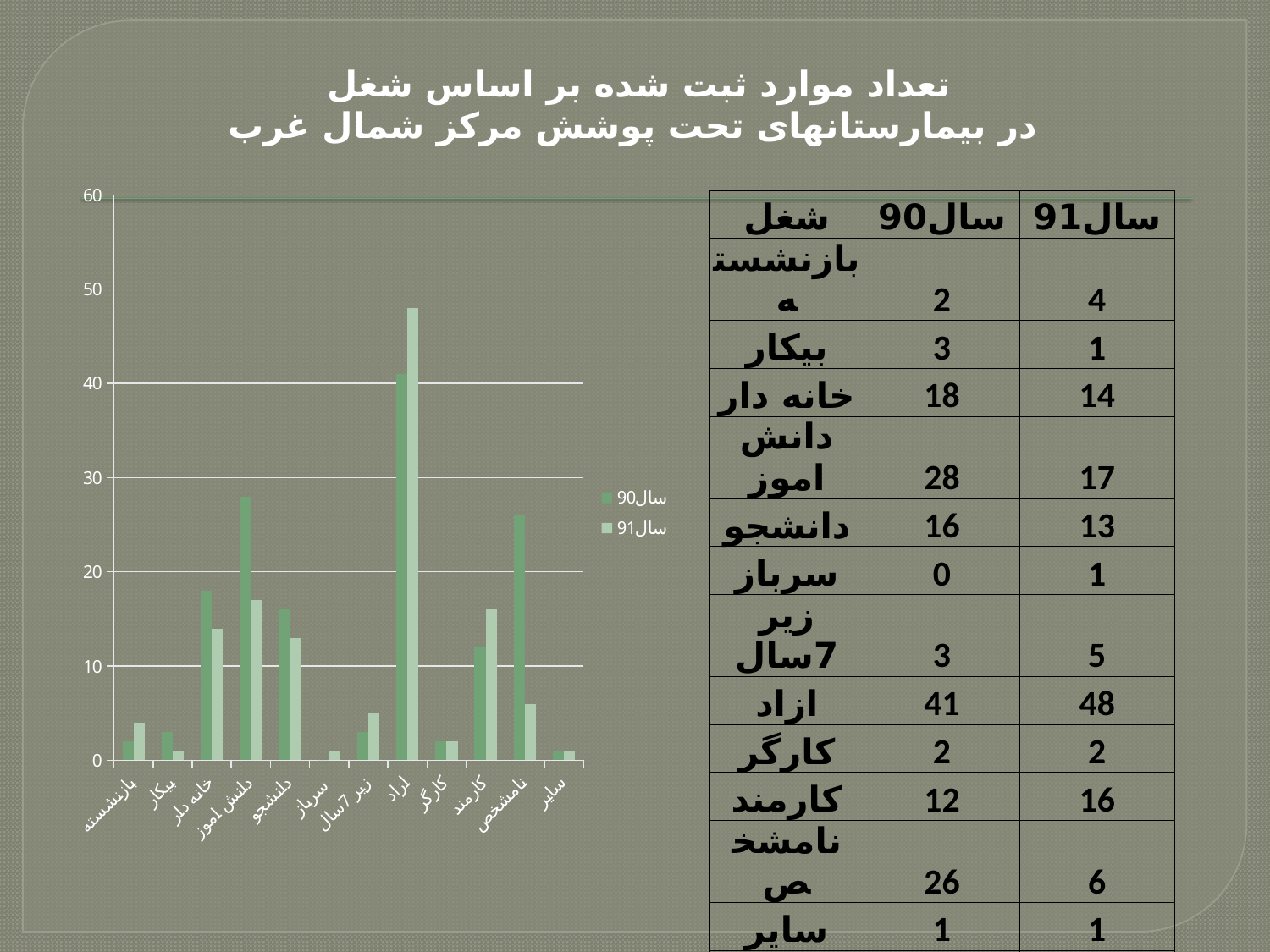
Which occupation category has the lowest value for سال90? سرباز What is the difference between the سال90 and سال91 values for نامشخص? 20 What is the difference between the سال90 and سال91 values for ازاد? 7 Which occupation category has the highest value for سال91? ازاد What is the value for ازاد in سال90? 41 How many series does the chart legend list? 2 What is the value for دانش اموز in سال90? 28 How many occupation categories are plotted along the x axis of the chart? 12 What is the value for نامشخص in سال91? 6 What kind of chart is shown on the slide? bar chart Is the value for ازاد in سال91 greater or less than 40? greater Which is larger for کارمند: the سال90 value or the سال91 value? سال91